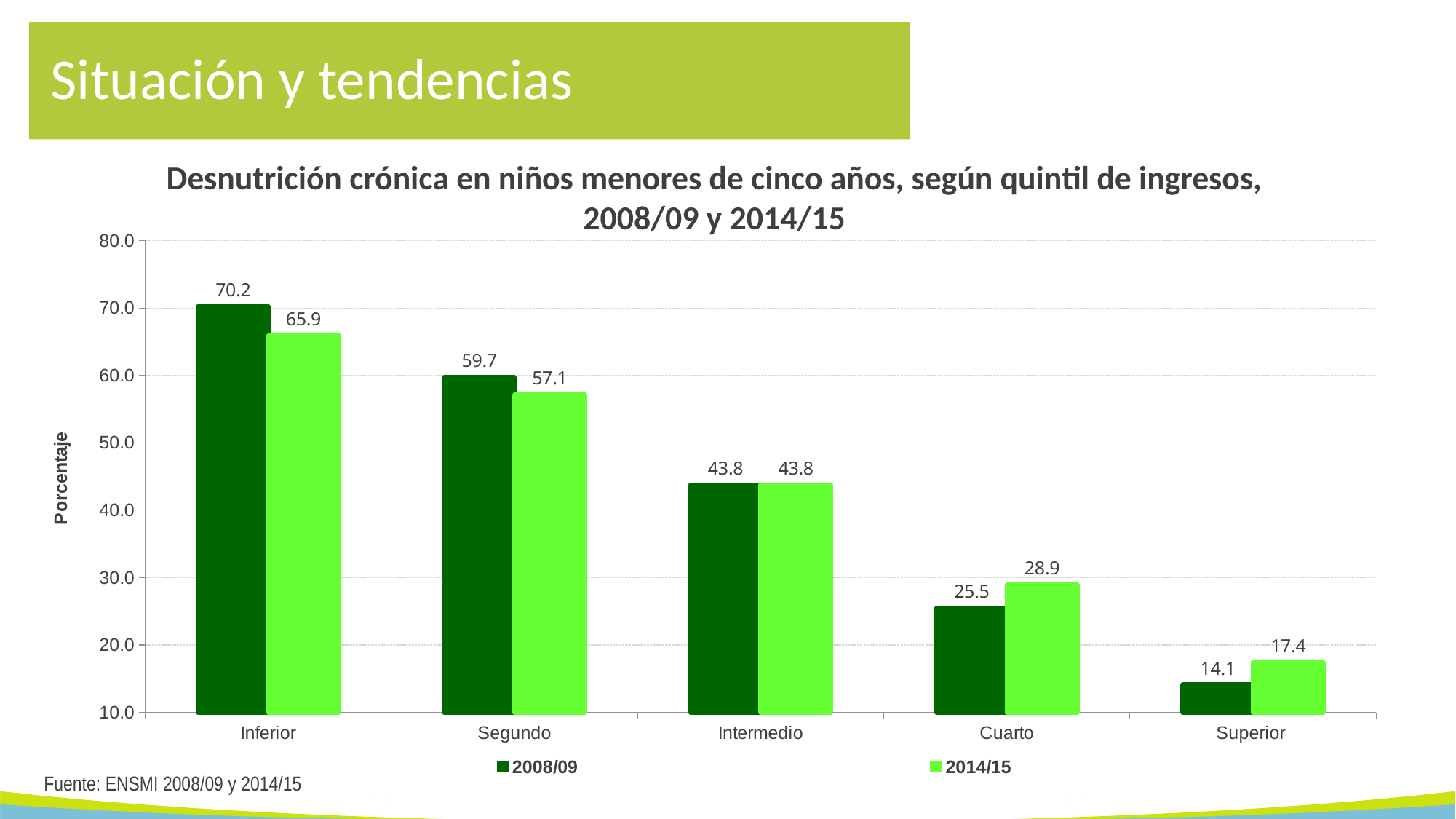
Do the 2008/09 values rise or fall from Inferior to Superior? Fall What is the value for Superior in the 2014/15 series? 17.4 What kind of chart is shown on the slide? Bar chart How many income quintiles are shown on the x axis? 5 What is the value for Cuarto in the 2008/09 series? 25.5 How many series does the legend list? 2 What is the value for Inferior in the 2008/09 series? 70.2 Which quintile has the lowest value in the 2008/09 series? Superior Which quintile has the highest value in the 2014/15 series? Inferior What is the difference between the 2008/09 and 2014/15 values for Inferior? 4.3 What is the difference between the 2014/15 and 2008/09 values for Cuarto? 3.4 For Segundo, which series has the larger value, 2008/09 or 2014/15? 2008/09